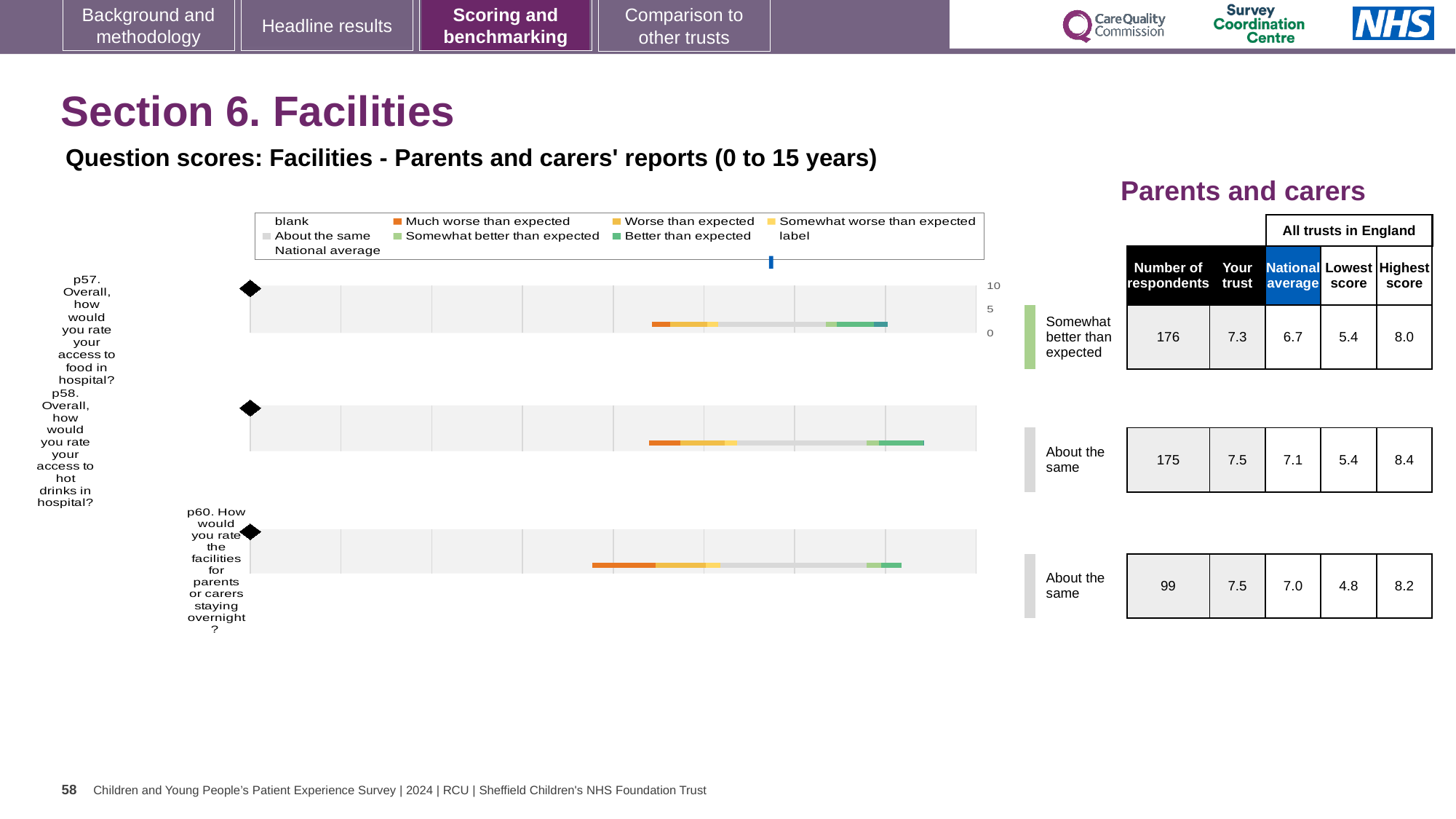
Which question has the highest national average? p58 What is the difference between the highest score and the lowest score for p58? 3.0 What benchmark category is shown for p57 (access to food in hospital)? Somewhat better than expected For p57, which is larger: the 'Your trust' score or the national average? Your trust What is the national average for p58 (access to hot drinks in hospital)? 7.1 How many respondents answered p60 (facilities for parents or carers staying overnight)? 99 What is the 'Your trust' score for p57 (access to food in hospital)? 7.3 What kind of chart is used to show the question scores for Facilities? bar chart What colour does the legend use for 'Much worse than expected'? orange How many questions (categories) are plotted in the Facilities question scores chart? 3 What is the subtitle above the chart describing the question scores? Question scores: Facilities - Parents and carers' reports (0 to 15 years) Which question has the lowest 'Lowest score' across all trusts in England? p60